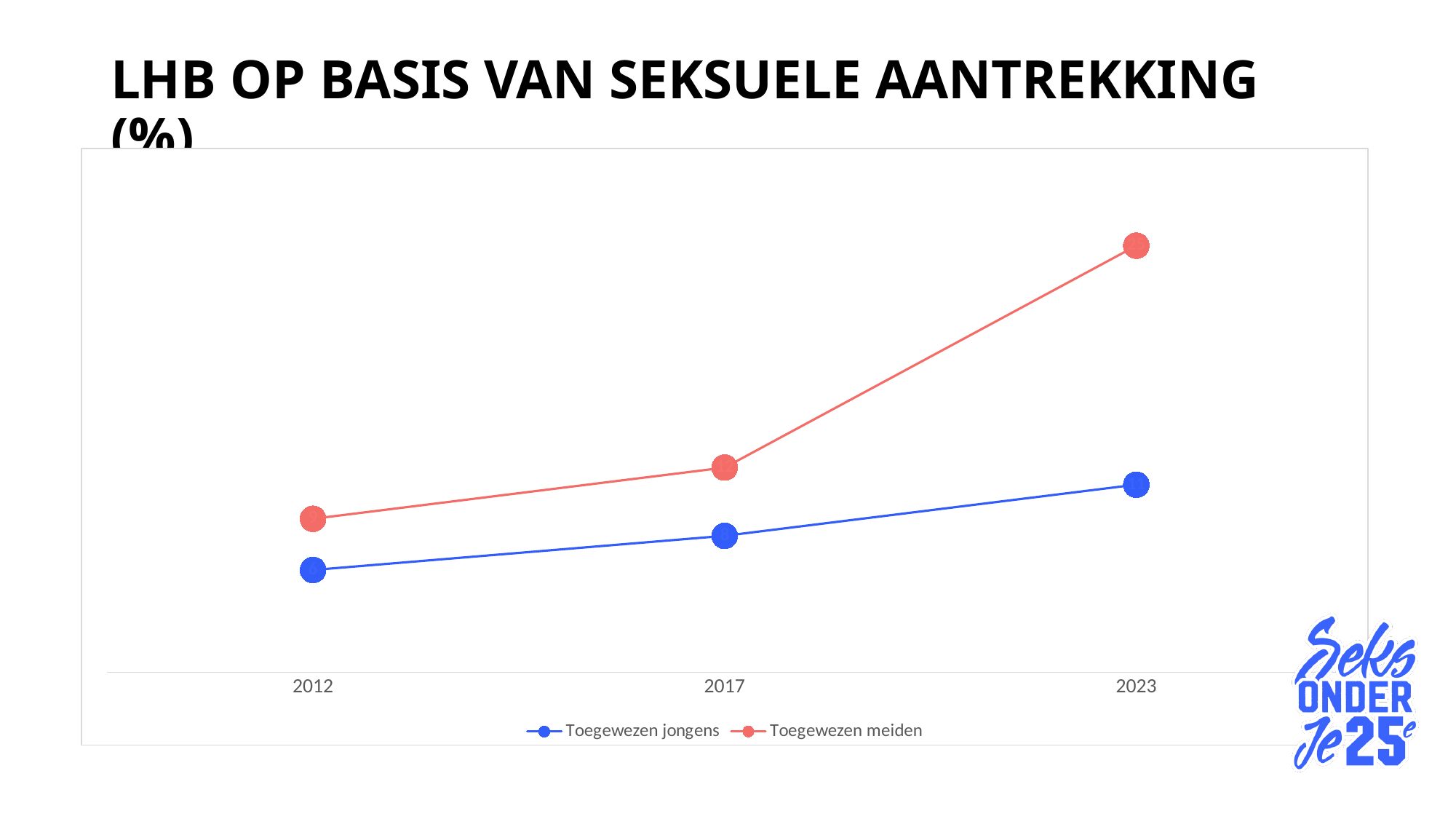
How many series does the legend list? 2 Does the value for Toegewezen meiden rise or fall from 2012 to 2023? rise In 2012, which series has the lower value, Toegewezen jongens or Toegewezen meiden? Toegewezen jongens In 2023, which series has the higher value, Toegewezen jongens or Toegewezen meiden? Toegewezen meiden Which years are shown on the x axis? 2012, 2017, 2023 What kind of chart is shown on the slide? line chart Does the value for Toegewezen jongens rise or fall from 2012 to 2023? rise In which year is the value for Toegewezen meiden highest? 2023 Which series is drawn in red? Toegewezen meiden How many years are plotted along the x axis? 3 Between which two consecutive years does the Toegewezen meiden line rise most steeply? 2017 and 2023 In which year is the value for Toegewezen jongens lowest? 2012